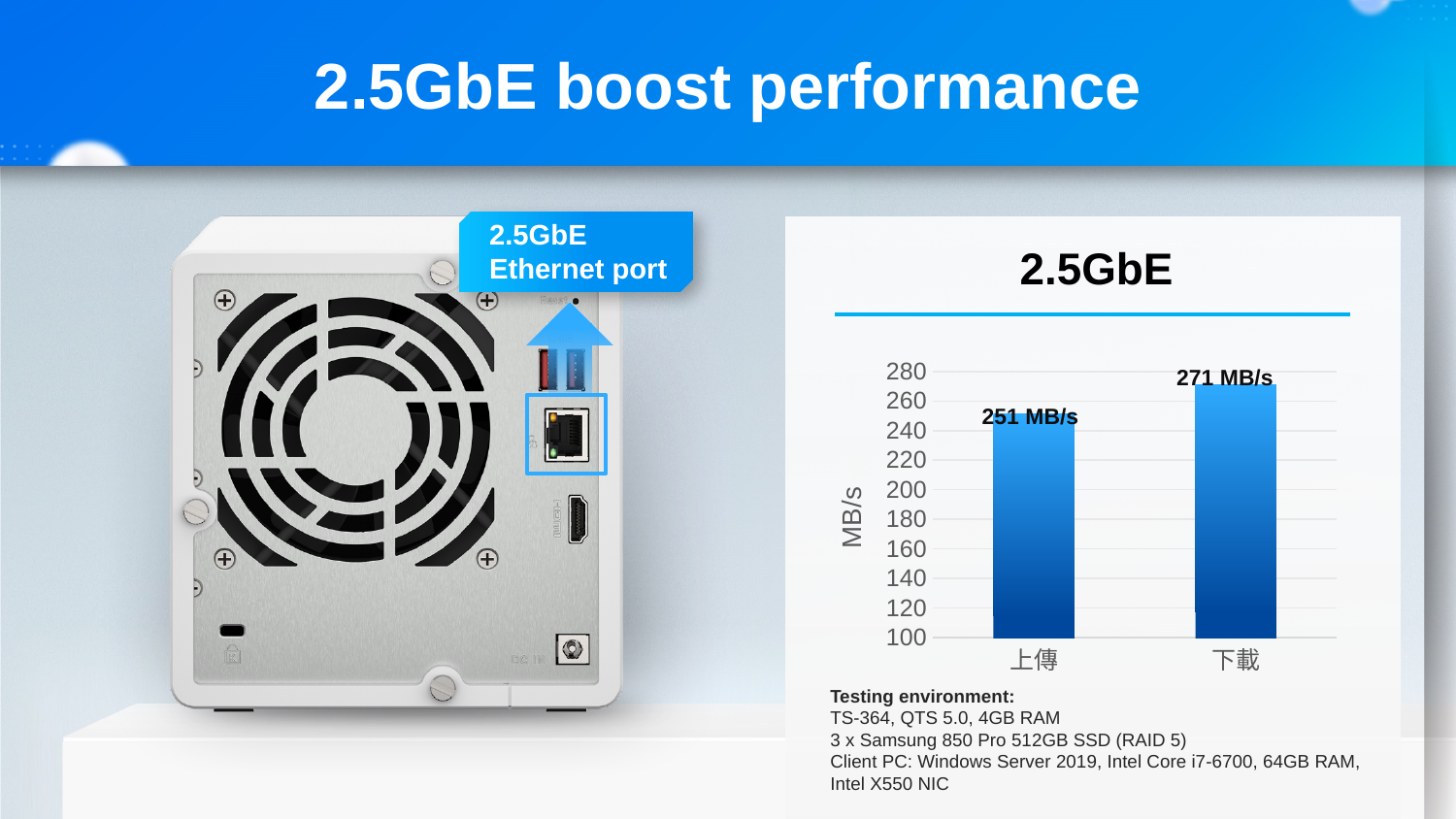
What kind of chart is the 2.5GbE chart? bar chart What is the difference between the 下載 and 上傳 values in the 2.5GbE chart? 20 MB/s What is the title of the chart on the slide? 2.5GbE Is the value for 上傳 greater or less than 240 in the 2.5GbE chart? greater What is the value for 上傳 in the 2.5GbE chart? 251 MB/s Which category has the highest value in the 2.5GbE chart? 下載 Which category has the lowest value in the 2.5GbE chart? 上傳 Which is larger in the 2.5GbE chart, the value for 上傳 or the value for 下載? 下載 How many categories are shown in the 2.5GbE chart? 2 What unit is shown on the y-axis of the 2.5GbE chart? MB/s Is the value for 下載 greater or less than 280 in the 2.5GbE chart? less What is the value for 下載 in the 2.5GbE chart? 271 MB/s